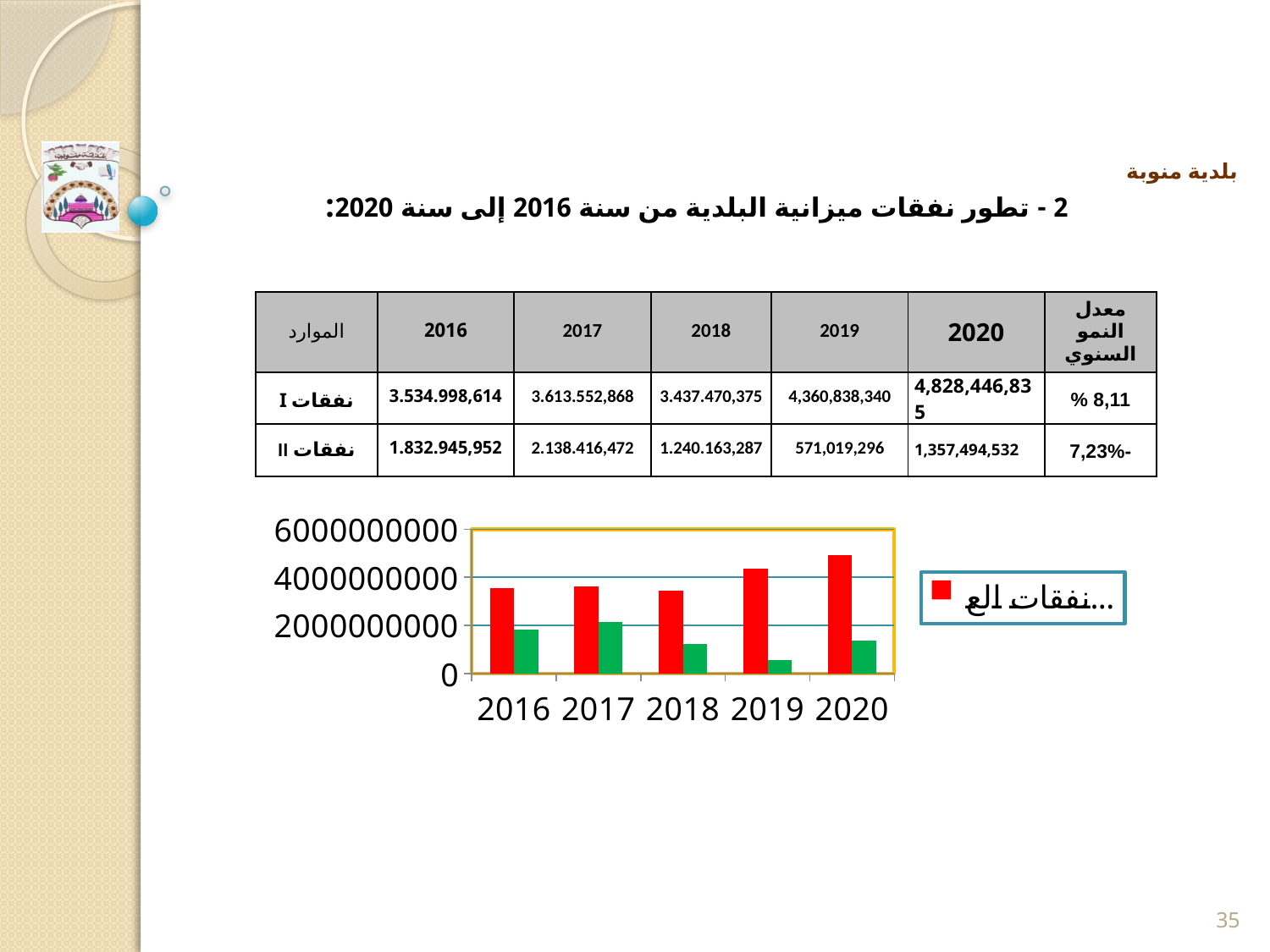
Is the red bar for 2016 greater or less than 4000000000? less What kind of chart is shown on the slide? bar chart Which is taller, the red bar for 2019 or the red bar for 2017? 2019 What is the highest value shown on the chart's vertical axis? 6000000000 How many bars are plotted for each year in the chart? 2 In which year is the green bar the shortest? 2019 Is the red bar for 2020 greater or less than 4000000000? greater Is the green bar for 2019 greater or less than 2000000000? less In which year is the green bar the tallest? 2017 Do the red bars rise or fall from 2018 to 2020? rise How many years are shown on the x axis of the chart? 5 In which year is the red bar the tallest? 2020